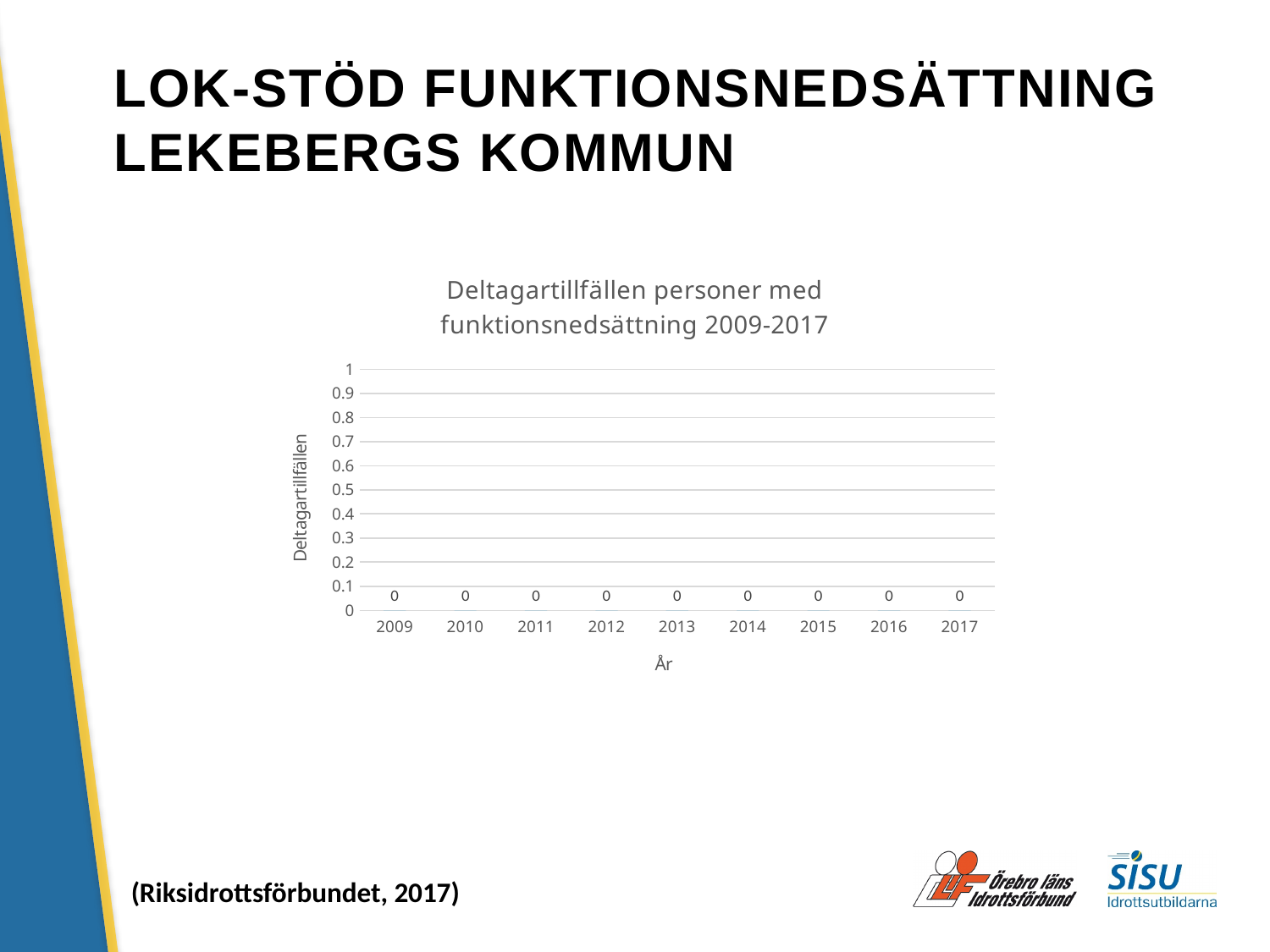
How many years are shown on the x axis of the chart? 9 What is the label of the x axis of the chart? År What is the title of the chart? Deltagartillfällen personer med funktionsnedsättning 2009-2017 What is the difference between the values for 2009 and 2017? 0 Is the value for 2012 greater or less than 0.5? less Do the values rise, fall or stay the same from 2009 to 2017? stay the same What is the value for 2017 in the chart? 0 What is the value for 2015 in the chart? 0 Is the value for 2016 greater or less than 0.1? less What is the value for 2009 in the chart? 0 What is the value for 2013 in the chart? 0